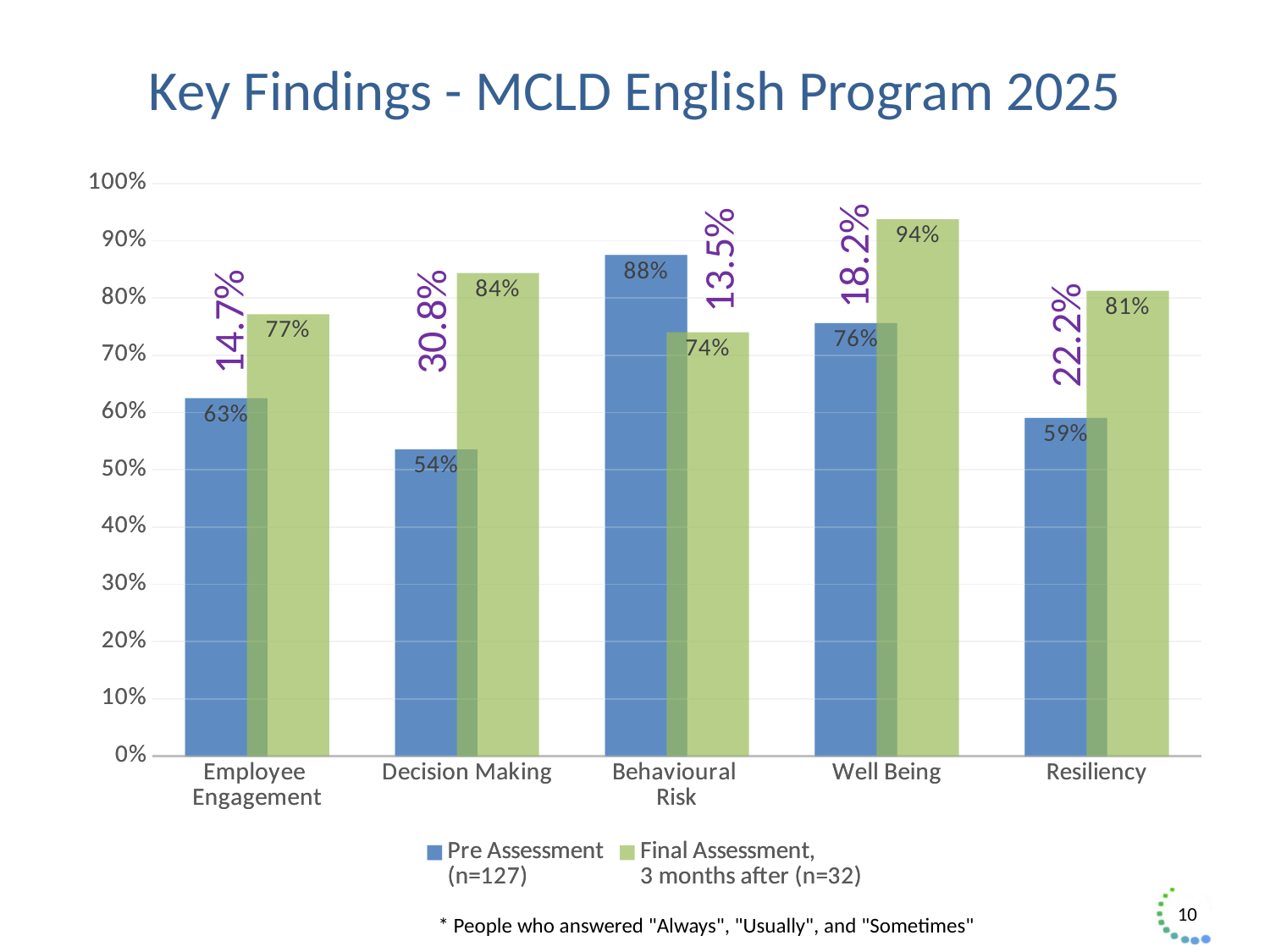
Which category has the highest Final Assessment value? Well Being What is the Pre Assessment value for Employee Engagement? 63% How many categories are shown on the x axis? 5 Is the Pre Assessment value for Resiliency greater or less than 70%? less What is the title of the slide? Key Findings - MCLD English Program 2025 Which category has the lowest Pre Assessment value? Decision Making What is the difference between the Final Assessment and Pre Assessment values for Decision Making? 30% For Behavioural Risk, which is larger: the Pre Assessment value or the Final Assessment value? Pre Assessment What is the Pre Assessment value for Behavioural Risk? 88% What kind of chart is shown on the slide? bar chart What is the Final Assessment value for Well Being? 94% How many series does the legend list? 2